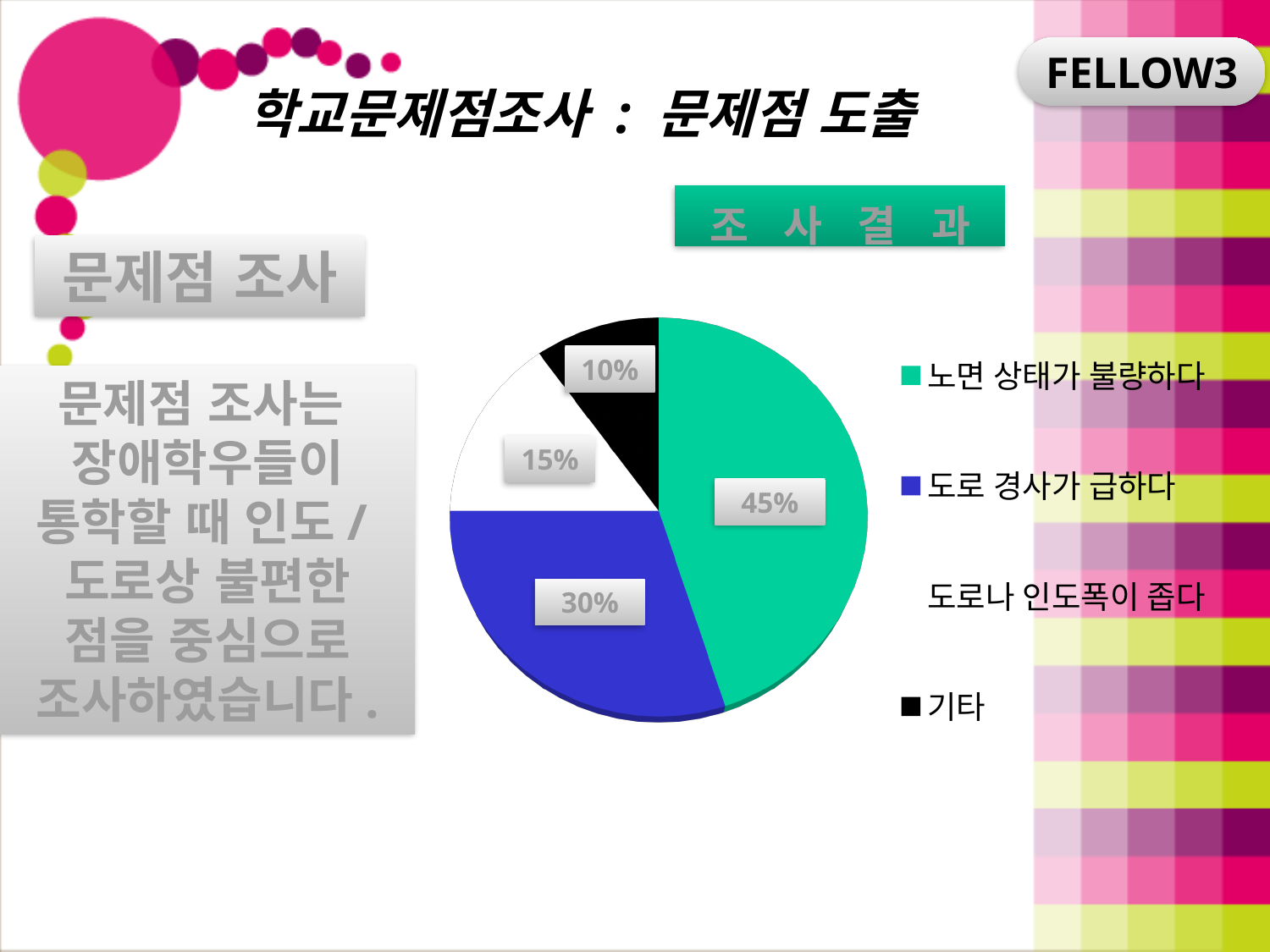
What percentage of the pie chart is labelled for 도로나 인도폭이 좁다? 15% What colour is the slice for 도로 경사가 급하다 in the pie chart? blue What is the difference in percentage points between 노면 상태가 불량하다 and 도로 경사가 급하다? 15 What percentage of the pie chart is labelled for 도로 경사가 급하다? 30% What percentage of the pie chart is labelled for 노면 상태가 불량하다? 45% How many entries does the legend of the pie chart list? 4 How many slices does the pie chart have? 4 What kind of chart is shown on the slide? pie chart Which category has the largest slice in the pie chart? 노면 상태가 불량하다 Which category has the smallest slice in the pie chart? 기타 What percentage of the pie chart is labelled for 기타? 10% Which is larger in the pie chart: 도로나 인도폭이 좁다 or 기타? 도로나 인도폭이 좁다